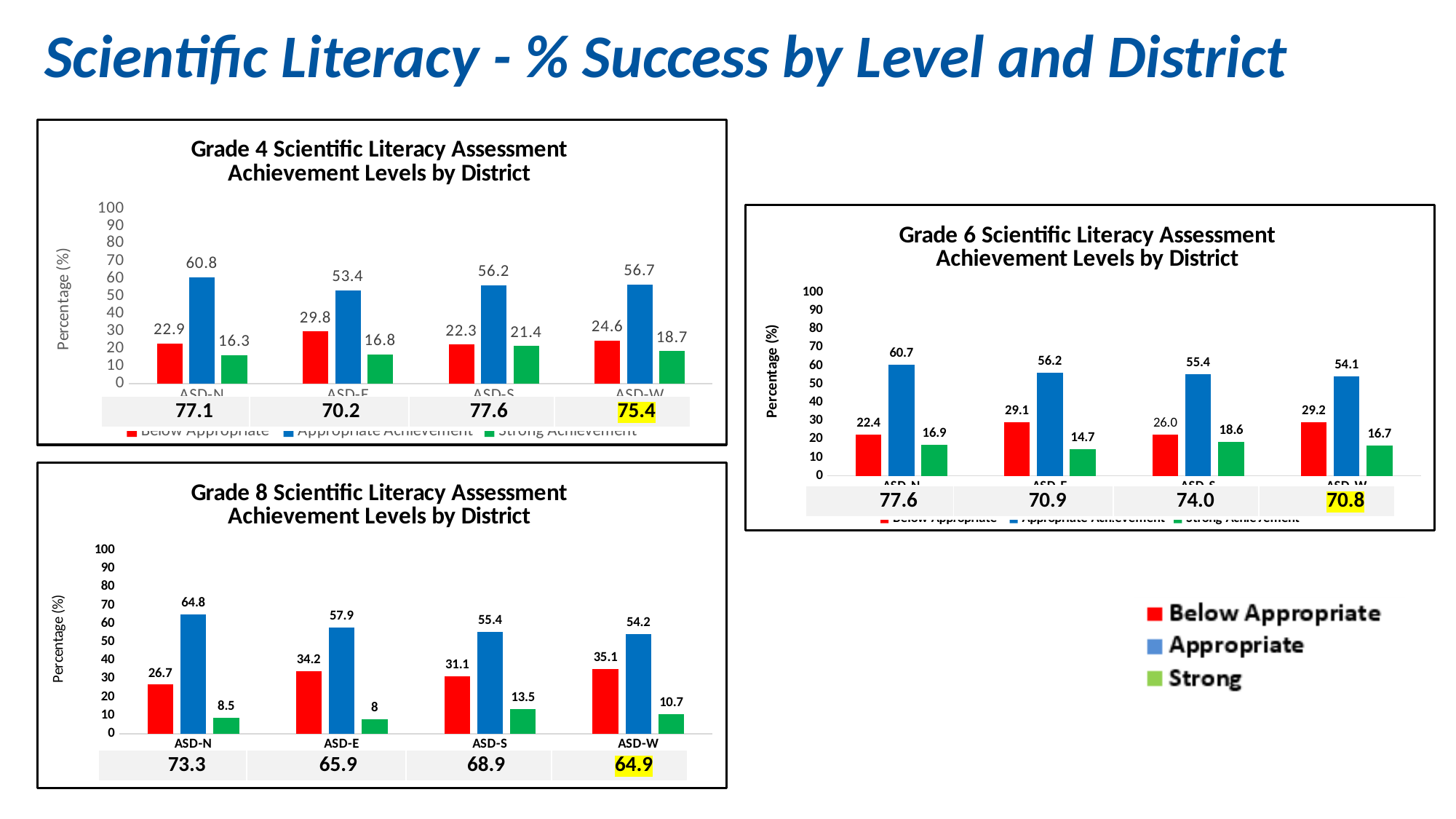
In the Grade 8 Scientific Literacy Assessment chart, which is larger: the Below Appropriate value for ASD-W or for ASD-N? ASD-W In the Grade 4 Scientific Literacy Assessment chart, what is the Appropriate Achievement value for ASD-N? 60.8 How many districts are shown on the x axis of the Grade 4 Scientific Literacy Assessment chart? 4 In the Grade 6 Scientific Literacy Assessment chart, what is the Below Appropriate value for ASD-E? 29.1 In the Grade 8 Scientific Literacy Assessment chart, which district has the highest Appropriate Achievement value? ASD-N In the Grade 8 Scientific Literacy Assessment chart, what is the highlighted value shown below ASD-W? 64.9 In the Grade 6 Scientific Literacy Assessment chart, which district has the lowest Strong Achievement value? ASD-E In the Grade 6 Scientific Literacy Assessment chart, is the Appropriate Achievement value for ASD-N greater or less than 50? greater What type of chart is the Grade 6 Scientific Literacy Assessment chart? bar chart In the Grade 4 Scientific Literacy Assessment chart, what is the difference between the Appropriate Achievement values for ASD-N and ASD-E? 7.4 In the Grade 8 Scientific Literacy Assessment chart, what is the Strong Achievement value for ASD-S? 13.5 How many series does the legend list for the Grade 8 Scientific Literacy Assessment chart? 3